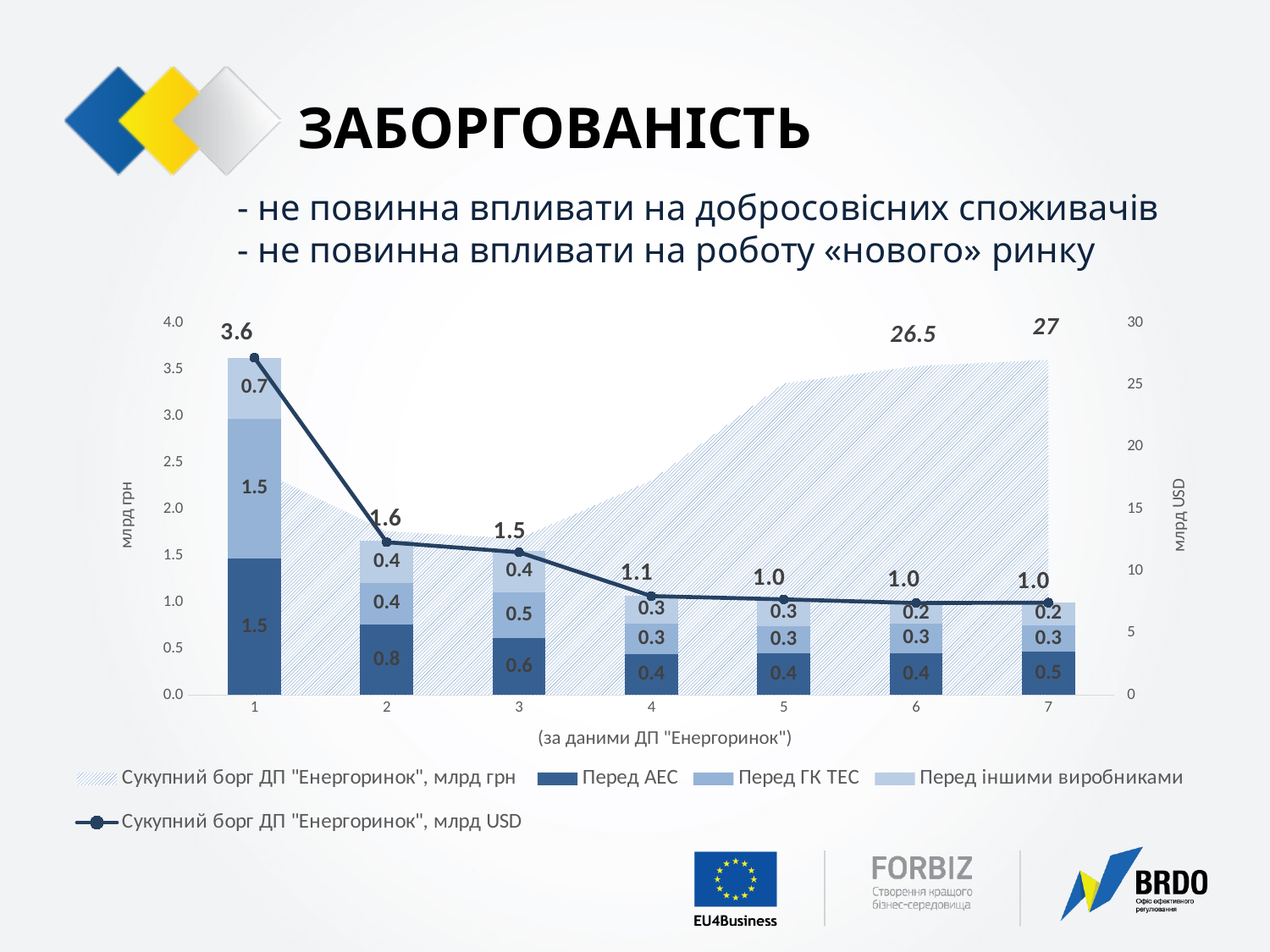
What is the value of "Перед АЕС" for category 1? 1.5 Does the line series "Сукупний борг ДП "Енергоринок", млрд USD" rise or fall from category 1 to category 7? fall What is the value of "Перед ГК ТЕС" for category 3? 0.5 What value is labelled on the shaded area "Сукупний борг ДП "Енергоринок", млрд грн" at category 7? 27 What is the difference between the "Перед АЕС" values for category 1 and category 2? 0.7 What is the value of "Перед іншими виробниками" for category 1? 0.7 Which is larger, the "Перед АЕС" value for category 2 or for category 3? category 2 How many series does the legend list? 5 What is the label of the left vertical axis? млрд грн What is the value of the line series "Сукупний борг ДП "Енергоринок", млрд USD" at category 1? 3.6 How many categories are shown on the x axis? 7 Which category has the highest value for "Перед АЕС"? 1